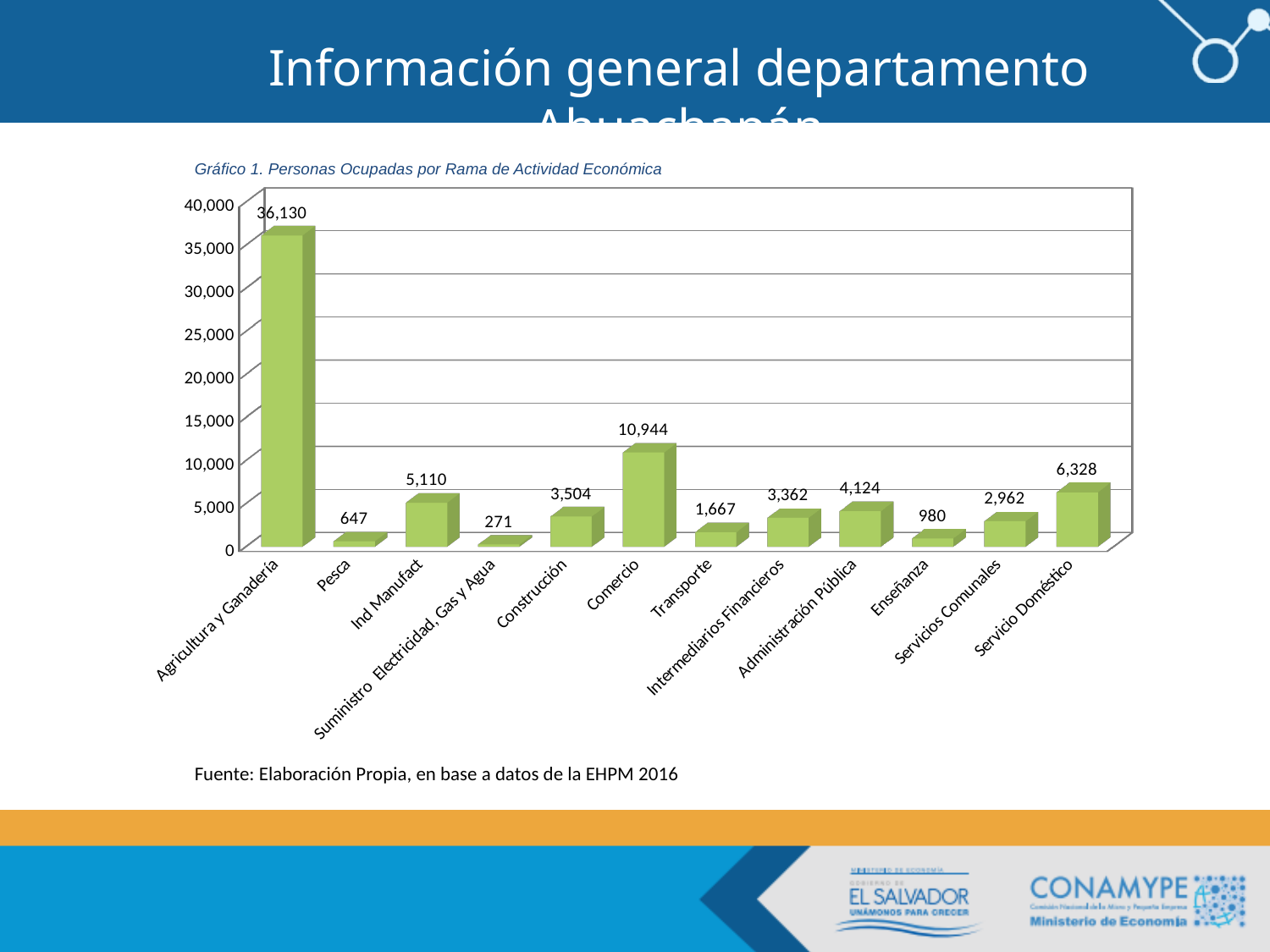
What is the title of the chart? Gráfico 1. Personas Ocupadas por Rama de Actividad Económica What is the difference between the values for Ind Manufact and Construcción? 1,606 Which category has the highest value? Agricultura y Ganadería Which is larger, the value for Transporte or the value for Enseñanza? Transporte Is the value for Servicio Doméstico greater or less than 5,000? greater What is the value for Comercio? 10,944 What is the value for Administración Pública? 4,124 What kind of chart is shown on the slide? Bar chart What is the difference between the values for Agricultura y Ganadería and Comercio? 25,186 What is the value for Servicio Doméstico? 6,328 How many categories are shown on the x axis? 12 Which category has the lowest value? Suministro Electricidad, Gas y Agua